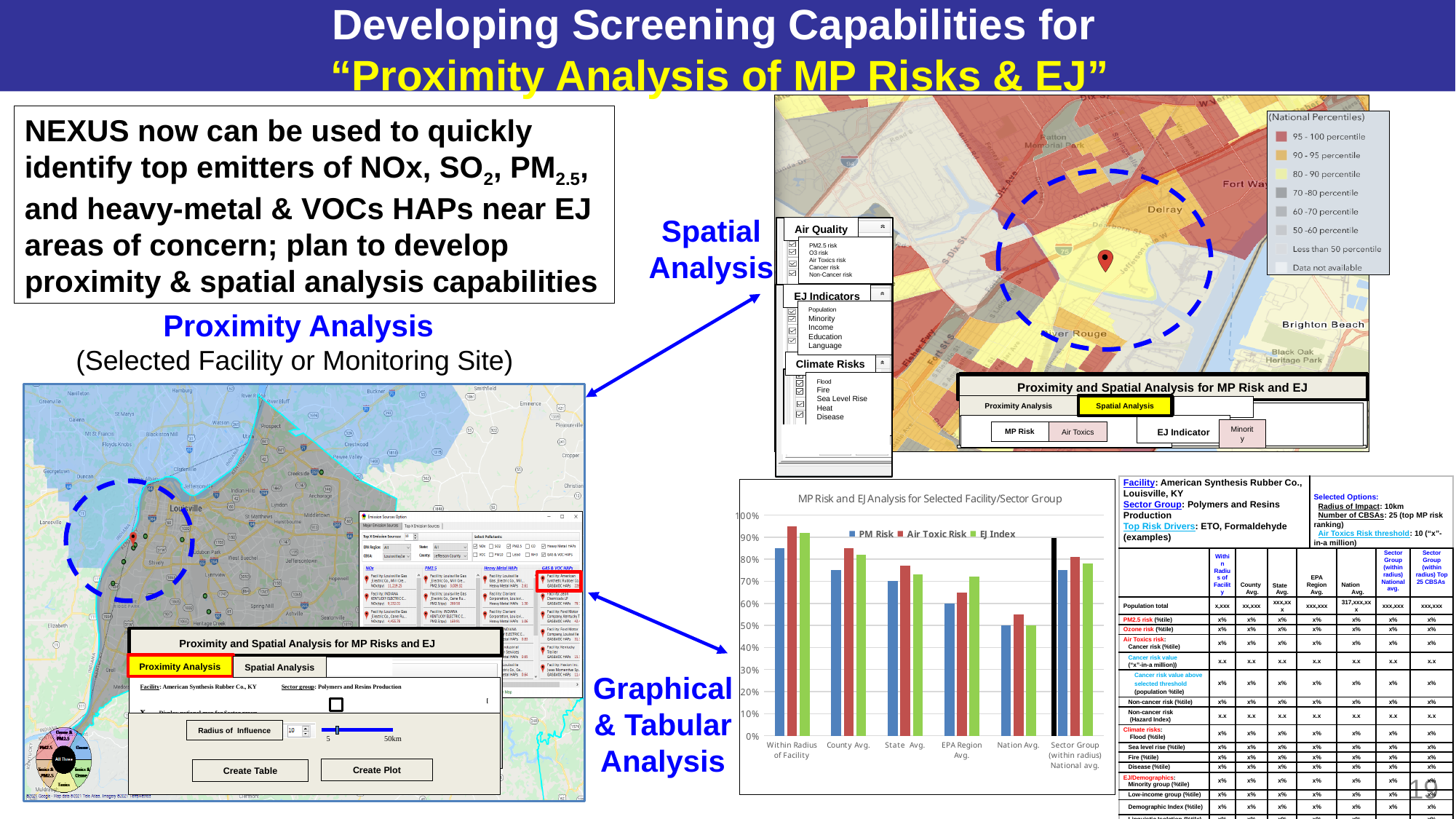
Which series are listed in the legend of the bar chart? PM Risk, Air Toxic Risk, EJ Index What is the title of the bar chart? MP Risk and EJ Analysis for Selected Facility/Sector Group Is the PM Risk value for EPA Region Avg. greater or less than 70%? less Which is larger: the Air Toxic Risk value for Within Radius of Facility or for Nation Avg.? Within Radius of Facility How many series does the legend of the bar chart list? 3 Do the PM Risk values rise or fall from Within Radius of Facility to Nation Avg. along the x axis? fall Is the PM Risk value for Nation Avg. greater or less than 60%? less Which category has the highest Air Toxic Risk value in the bar chart? Within Radius of Facility Is the Air Toxic Risk value for Within Radius of Facility greater or less than 90%? greater How many categories are shown along the x axis of the bar chart? 6 What kind of chart is shown on the slide? bar chart Which category has the lowest PM Risk value in the bar chart? Nation Avg.